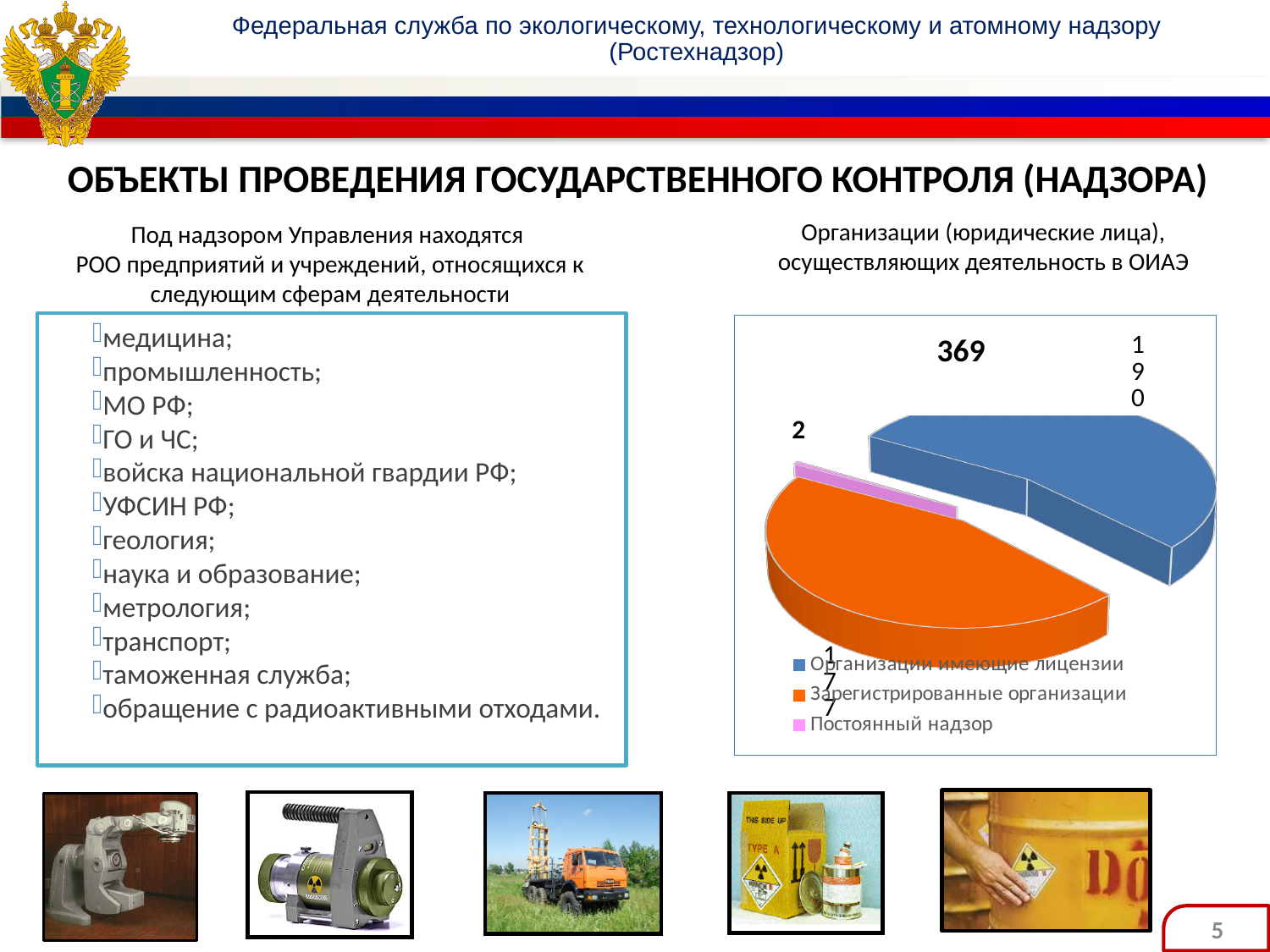
Is the value for Постоянный надзор larger or smaller than the value for Организации имеющие лицензии? smaller What is the heading above the pie chart? Организации (юридические лица), осуществляющих деятельность в ОИАЭ How many slices does the pie chart have? 3 Which slice of the pie chart is the smallest? Постоянный надзор What is the value shown for Организации имеющие лицензии in the pie chart? 190 What kind of chart is shown on the slide? pie chart Which legend entry is shown in pink in the pie chart? Постоянный надзор What is the value shown for Постоянный надзор in the pie chart? 2 How many entries does the legend of the pie chart list? 3